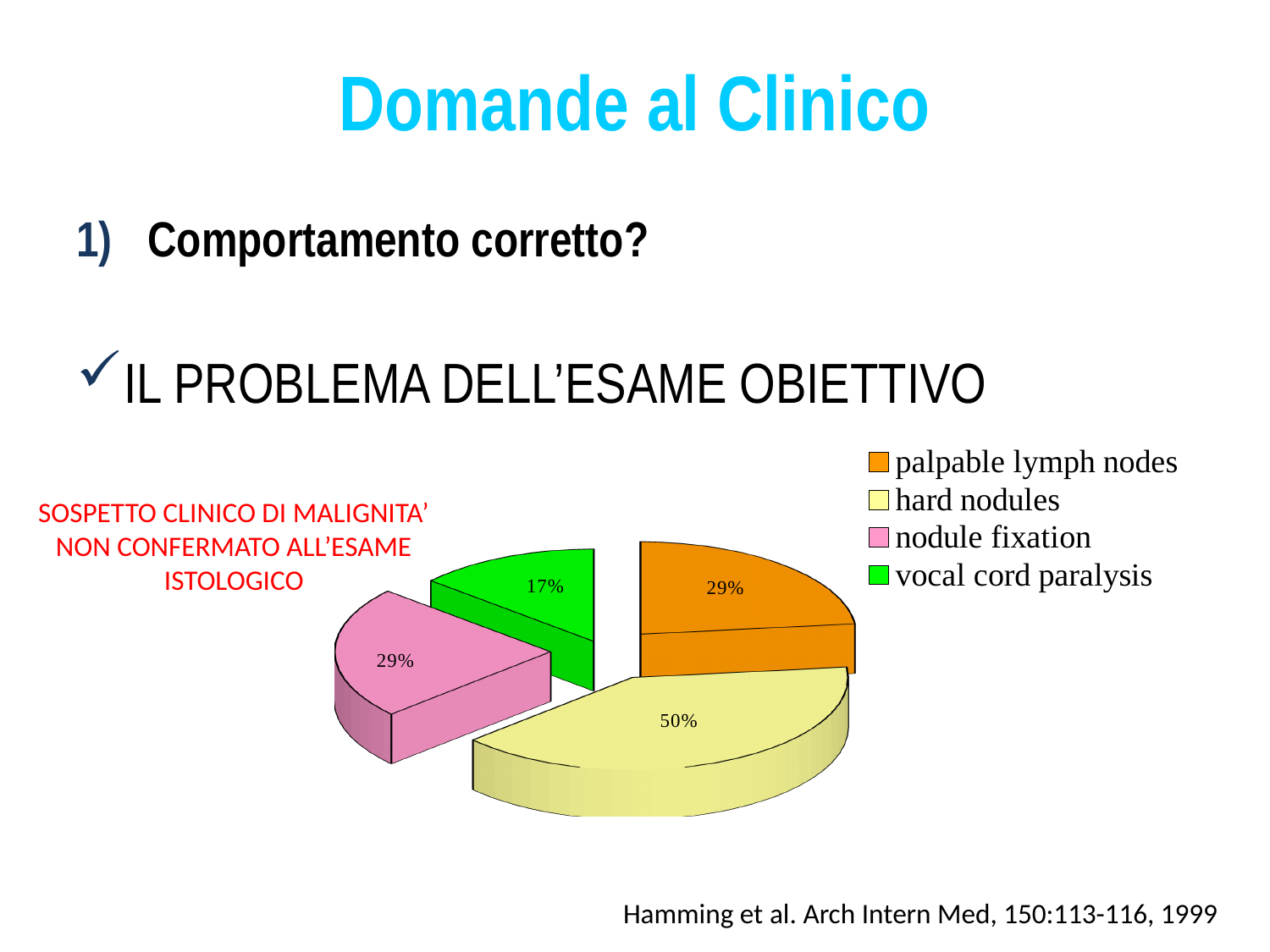
What is the difference in percentage points between hard nodules and vocal cord paralysis in the pie chart? 33 What percentage is shown for vocal cord paralysis in the pie chart? 17% What percentage is shown for nodule fixation in the pie chart? 29% How many slices does the pie chart have? 4 Which category has the largest slice in the pie chart? hard nodules Which colour represents vocal cord paralysis in the pie chart? green What percentage is shown for palpable lymph nodes in the pie chart? 29% Which category has the smallest slice in the pie chart? vocal cord paralysis What kind of chart is shown on the slide? pie chart What percentage is shown for hard nodules in the pie chart? 50% Which is larger in the pie chart: hard nodules or vocal cord paralysis? hard nodules How many entries does the legend of the pie chart list? 4